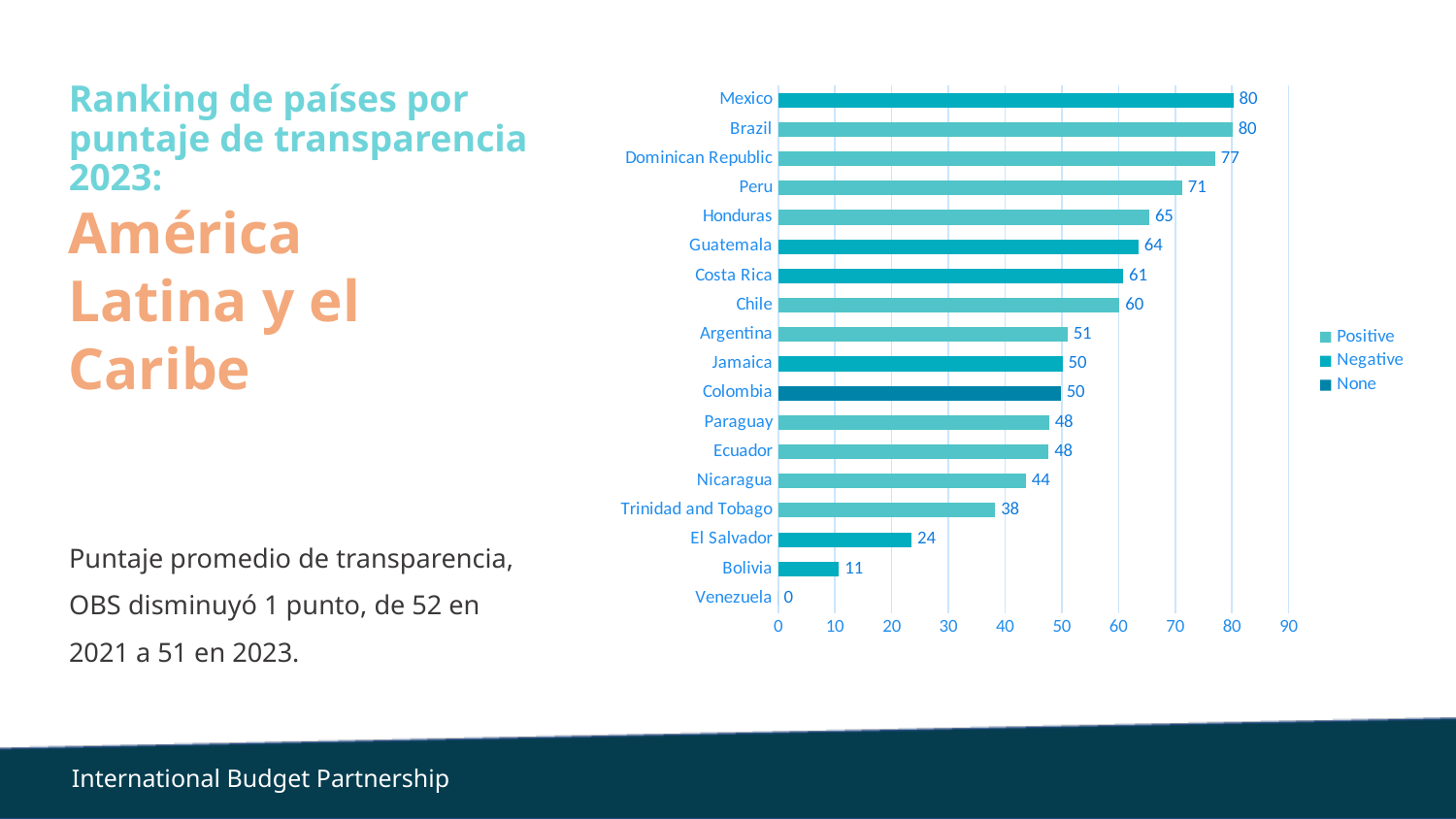
Which country's bar is shown in the dark blue colour labelled 'None' in the legend? Colombia What is the transparency score for Bolivia? 11 Is the value for Trinidad and Tobago greater or less than 40? less What is the transparency score for Nicaragua? 44 What is the difference between the scores of Dominican Republic and Honduras? 12 How many entries does the legend list? 3 Which country has the lowest transparency score? Venezuela What type of chart is shown on the slide? Bar chart Which has a higher transparency score, Chile or Argentina? Chile How many countries are shown in the chart? 18 Which two countries share the highest transparency score of 80? Mexico and Brazil What is the transparency score for Peru? 71